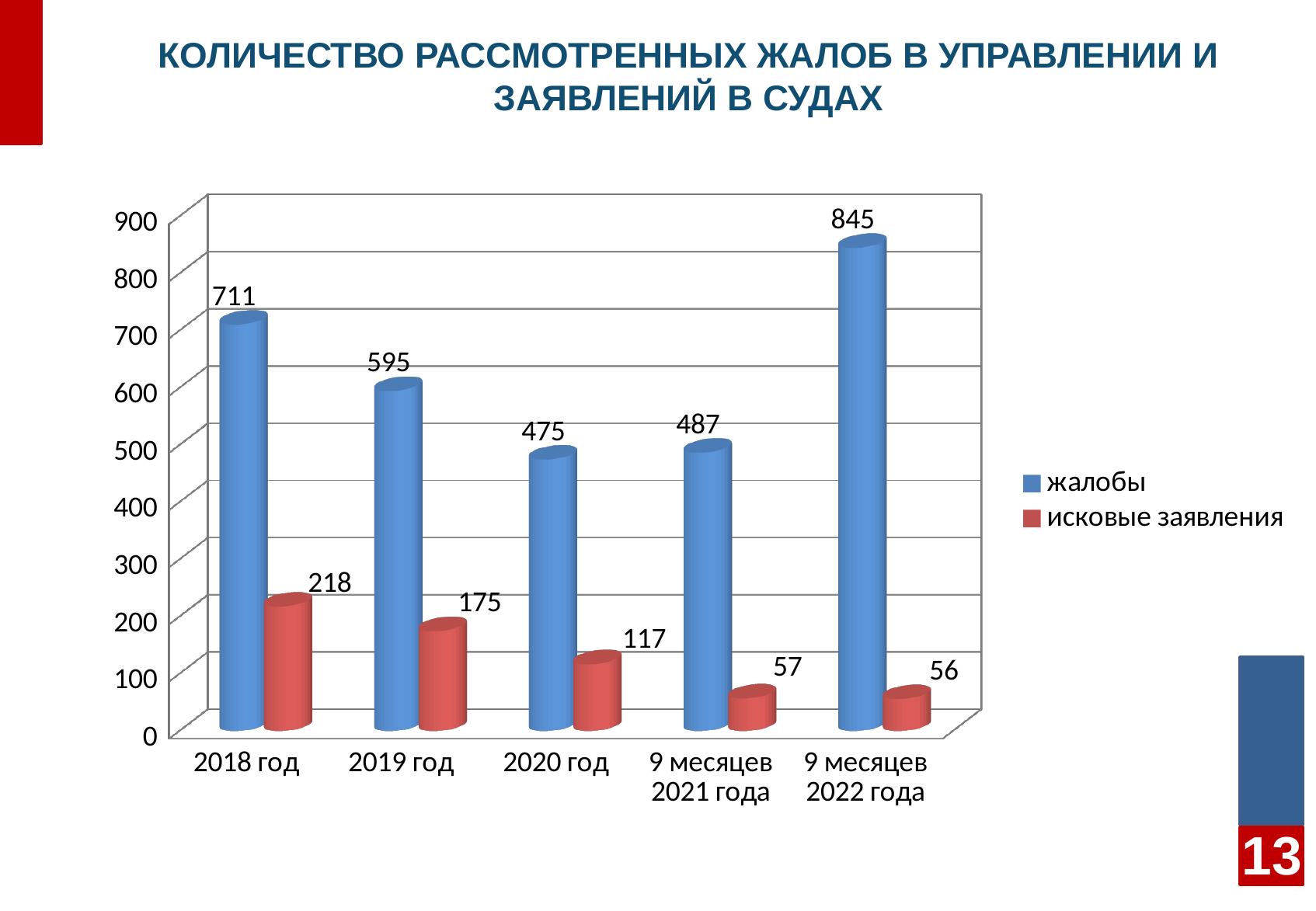
What is the value of жалобы for 9 месяцев 2022 года? 845 What is the value of исковые заявления for 2020 год? 117 What is the value of жалобы for 2018 год? 711 Which category has the lowest value for исковые заявления? 9 месяцев 2022 года What is the difference between жалобы for 2018 год and 2019 год? 116 How many series does the legend list? 2 Which is larger: исковые заявления for 2018 год or for 2019 год? 2018 год Do the values for исковые заявления rise or fall from 2018 год to 9 месяцев 2022 года? fall What kind of chart is shown on the slide? bar chart How many categories are shown on the x axis? 5 Which category has the highest value for жалобы? 9 месяцев 2022 года What colour are the bars for жалобы? blue